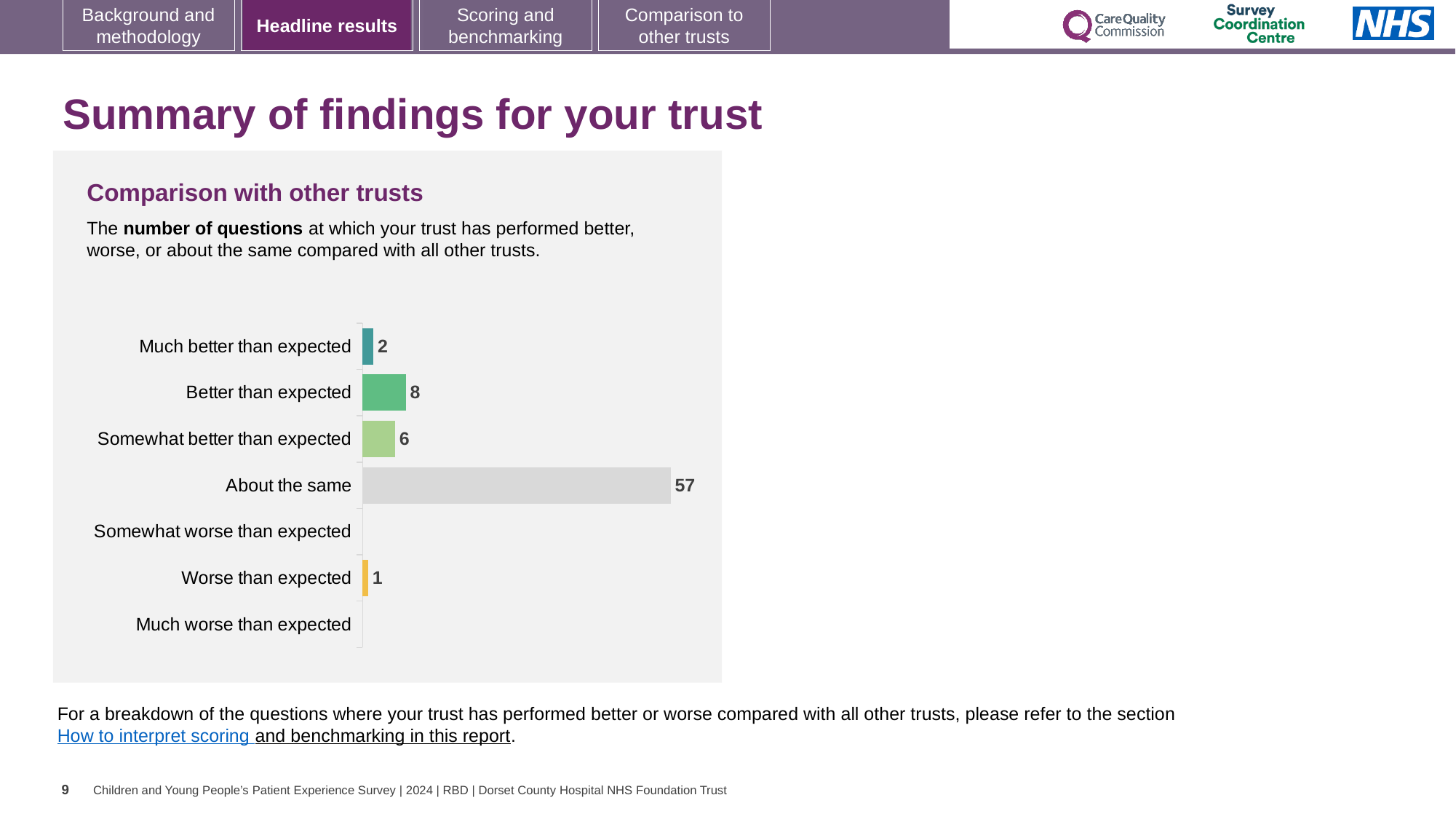
What is the value for 'Much better than expected'? 2 What is the value for 'Worse than expected'? 1 Which is larger, 'Somewhat better than expected' or 'Much better than expected'? Somewhat better than expected Which category has the highest number of questions? About the same What kind of chart is shown on the slide? Bar chart What colour is the bar for 'Worse than expected'? Orange What is the total number of questions across the three 'better than expected' categories? 16 What is the title of the chart? Comparison with other trusts How many categories are shown on the chart? 7 What is the value for 'Better than expected'? 8 What is the difference between 'Better than expected' and 'Somewhat better than expected'? 2 How many questions were rated 'About the same'? 57